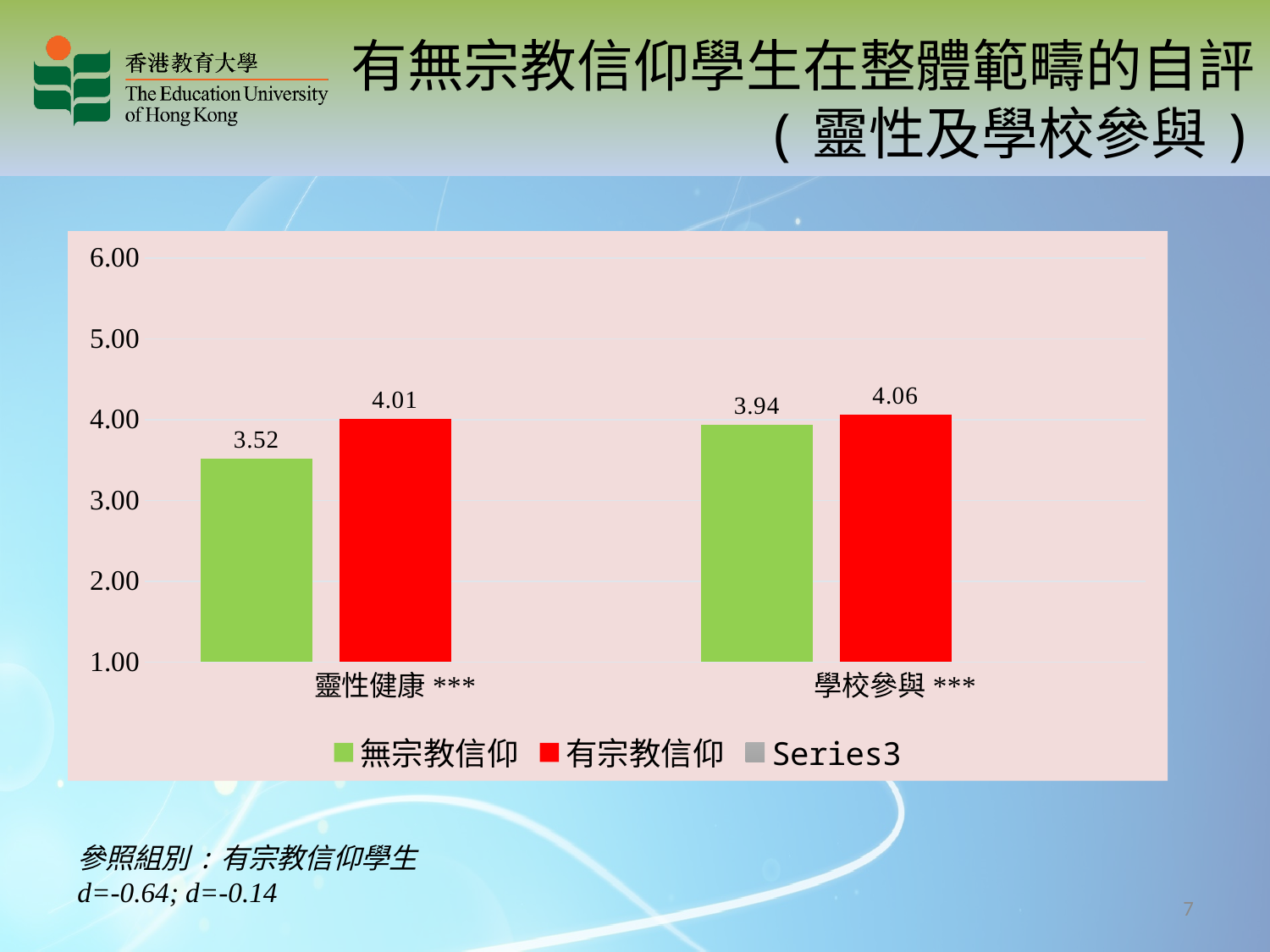
What is the value for 有宗教信仰 in the 靈性健康 *** category? 4.01 How many series does the legend list? 3 Which bar has the lowest value on the chart? 無宗教信仰 in 靈性健康 *** What is the value for 無宗教信仰 in the 靈性健康 *** category? 3.52 Is the value for 無宗教信仰 in 靈性健康 *** greater or less than 4.00? less How many categories are shown on the x axis? 2 What is the difference between the 有宗教信仰 and 無宗教信仰 values in the 靈性健康 *** category? 0.49 In the 靈性健康 *** category, which series has the larger value, 無宗教信仰 or 有宗教信仰? 有宗教信仰 What kind of chart is shown on the slide? bar chart What is the value for 無宗教信仰 in the 學校參與 *** category? 3.94 What is the difference between the 有宗教信仰 and 無宗教信仰 values in the 學校參與 *** category? 0.12 What is the value for 有宗教信仰 in the 學校參與 *** category? 4.06